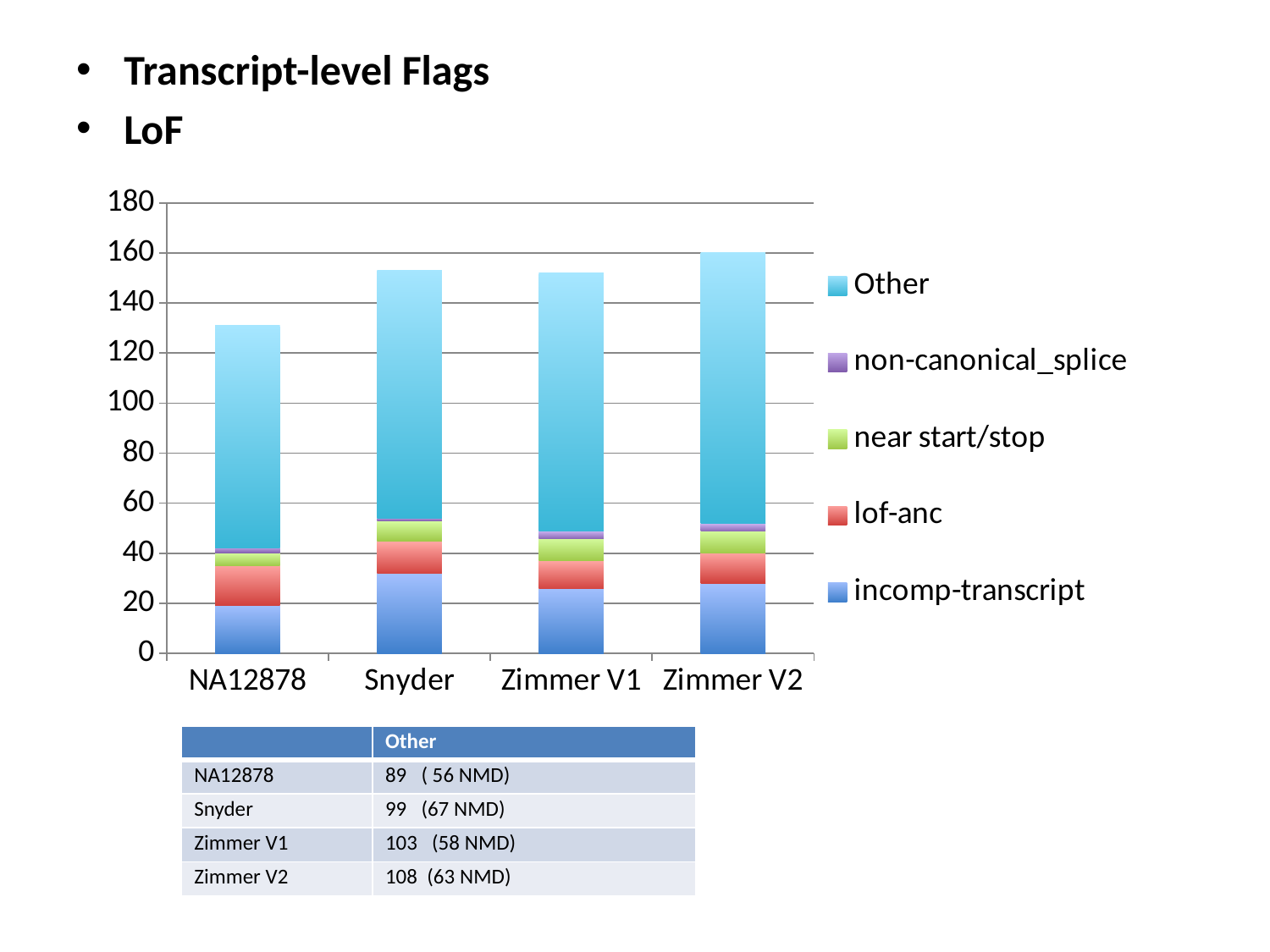
Which series is listed at the bottom of the chart legend? incomp-transcript How many categories are shown on the x axis of the chart? 4 Which category has the tallest stacked bar? Zimmer V2 Is the incomp-transcript value for Snyder greater or less than 20? greater Which has the larger total stacked bar, NA12878 or Snyder? Snyder How many series does the chart legend list? 5 Which category has the shortest stacked bar? NA12878 According to the table below the chart, what is the Other value for Zimmer V1? 103 Is the total stacked value for NA12878 greater or less than 140? less Is the total stacked value for Snyder greater or less than 140? greater What kind of chart is shown on the slide? stacked bar chart According to the table below the chart, what is the Other value for NA12878? 89